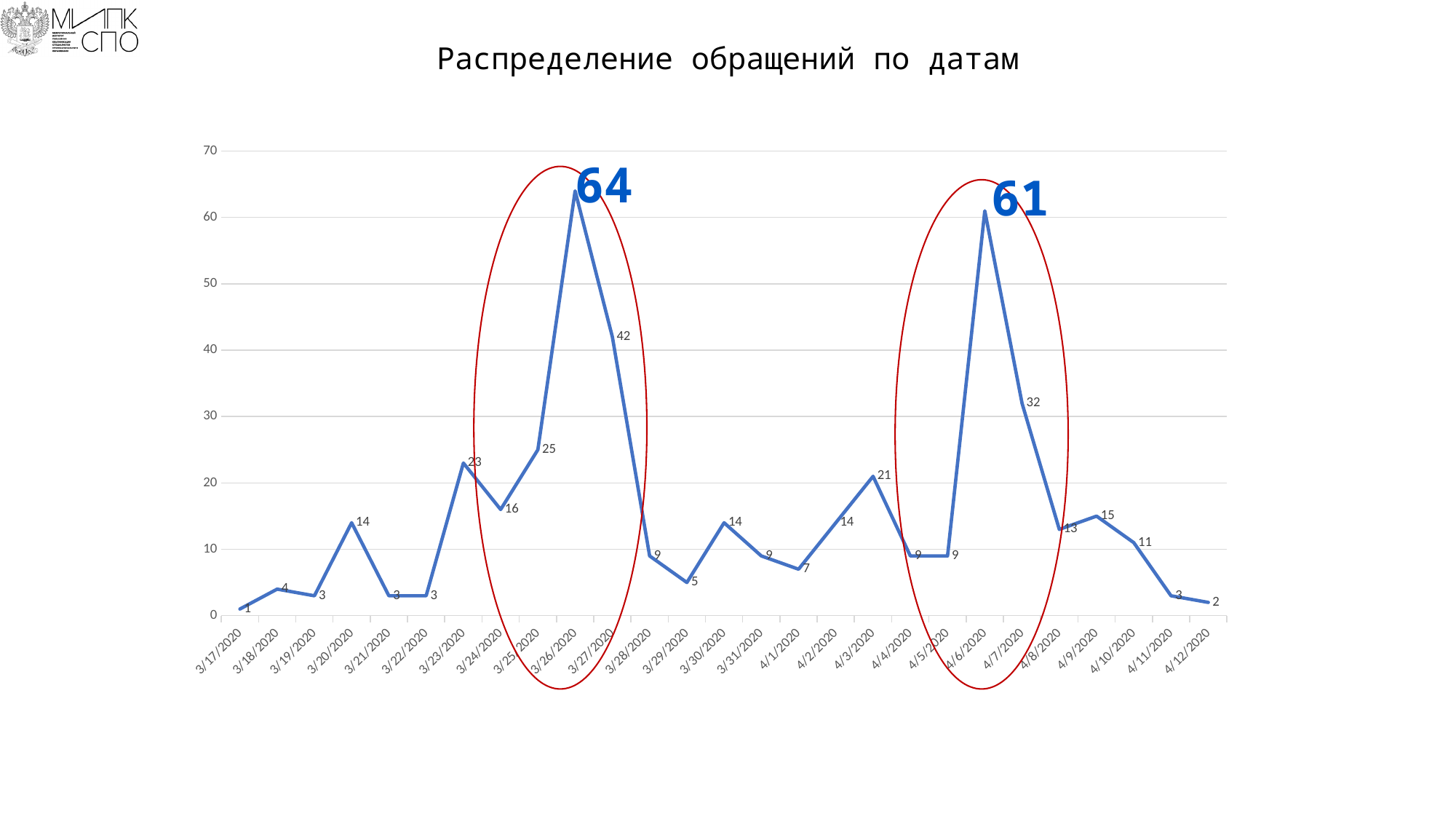
What is the title of the chart? Распределение обращений по датам What is the difference between the values for 3/26/2020 and 4/6/2020? 3 Which date has the lowest value? 3/17/2020 How many dates are plotted on the x axis? 27 What is the value for 3/27/2020? 42 What type of chart is shown on the slide? line chart Do the values rise or fall from 4/9/2020 to 4/12/2020? fall What is the value for 4/3/2020? 21 What is the value for 4/6/2020? 61 Which date has the highest value? 3/26/2020 What is the value for 3/26/2020? 64 Which is larger, the value for 3/23/2020 or the value for 4/7/2020? 4/7/2020